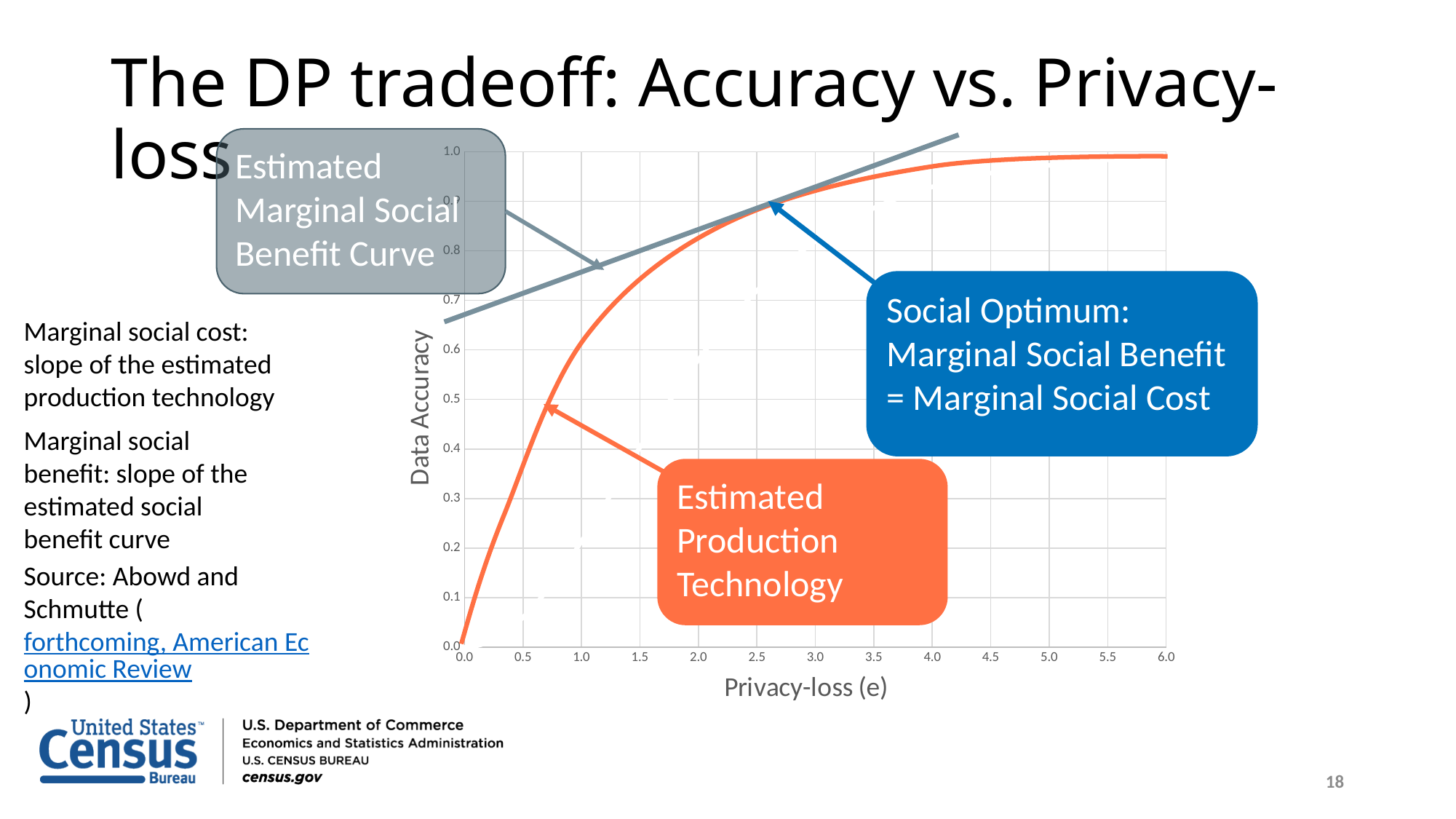
Does the Estimated Production Technology curve rise or fall as Privacy-loss increases? rise Is the Data Accuracy of the Estimated Production Technology curve at Privacy-loss 0.5 greater or less than 0.5? less Is the Data Accuracy of the Estimated Production Technology curve at Privacy-loss 1.0 greater or less than 0.5? greater Is the Data Accuracy of the Estimated Production Technology curve at Privacy-loss 4.0 greater or less than 0.9? greater What is the label of the y axis of the chart? Data Accuracy What is the label of the x axis of the chart? Privacy-loss (e) At Privacy-loss 1.0, which is higher: the Estimated Marginal Social Benefit Curve or the Estimated Production Technology curve? Estimated Marginal Social Benefit Curve Does the Estimated Marginal Social Benefit Curve rise or fall as Privacy-loss increases? rise How many curves are plotted on the chart? 2 What kind of chart is shown on the slide? line chart